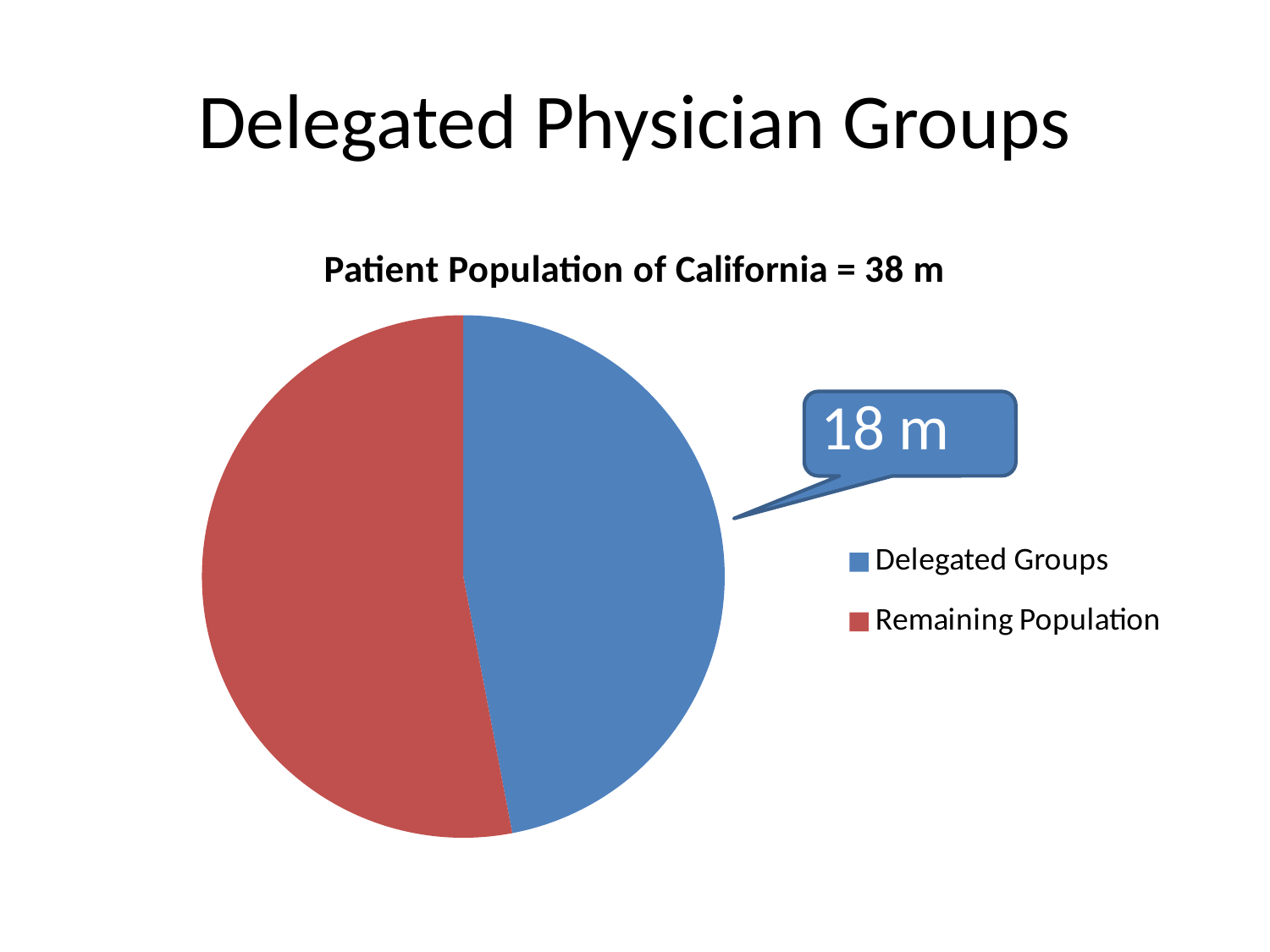
What is the total patient population of California stated in the chart title? 38 m What value is shown for the Delegated Groups slice? 18 m How many slices does the pie chart have? 2 Which slice of the pie is the smallest? Delegated Groups What is the title of the chart? Patient Population of California = 38 m How many entries does the legend list? 2 Which slice is larger, Delegated Groups or Remaining Population? Remaining Population What colour represents Delegated Groups in the pie chart? blue Which slice of the pie is the largest? Remaining Population By how much does the total patient population of 38 m exceed the Delegated Groups value of 18 m? 20 m What kind of chart is shown on the slide? pie chart